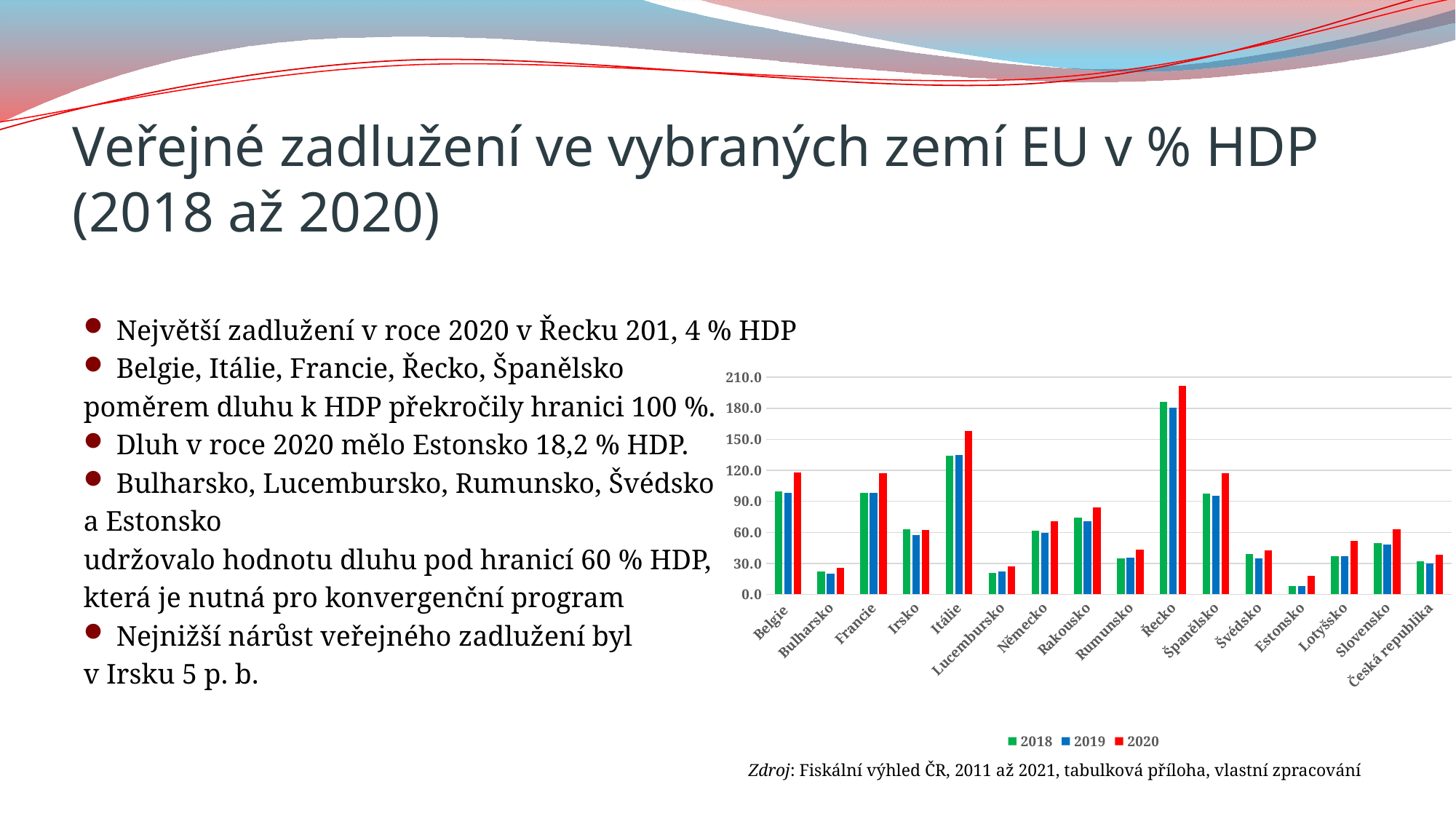
How many countries are shown on the x axis of the chart? 16 Which country has the highest value for 2020 in the chart? Řecko Which is larger in 2020: the value for Slovensko or the value for Lotyšsko? Slovensko Which colour represents the 2020 series in the chart legend? red Is the 2020 value for Itálie greater or less than 150? greater Which country has the lowest value for 2020 in the chart? Estonsko Is the 2020 value for Řecko greater or less than 180? greater How many series does the chart legend list? 3 Which is larger in 2020: the value for Rakousko or the value for Německo? Rakousko What kind of chart is shown on the slide? bar chart Is the 2020 value for Estonsko greater or less than 30? less